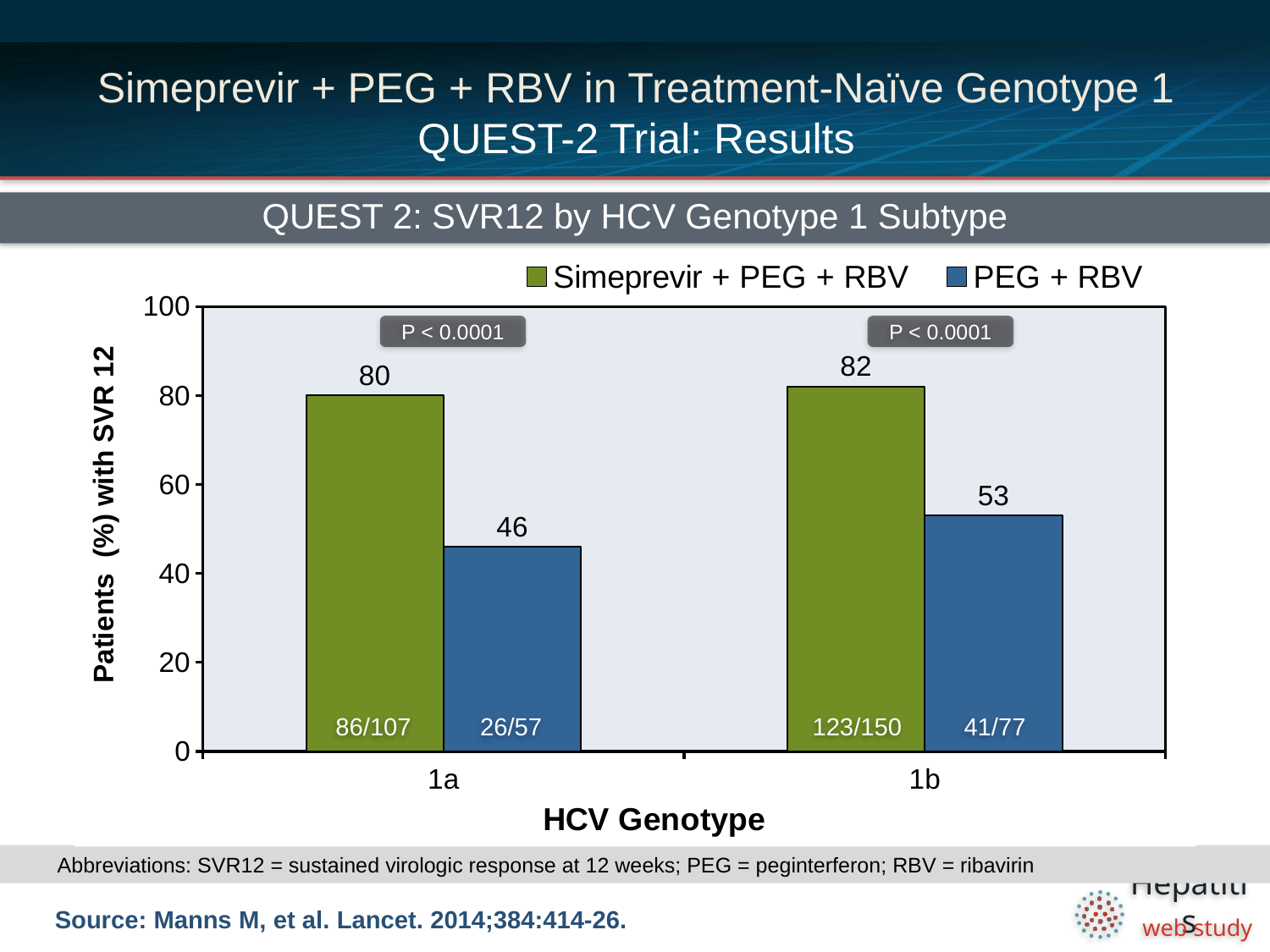
Which bar has the lowest SVR12 rate on the chart? PEG + RBV, genotype 1a Which bar has the highest SVR12 rate on the chart? Simeprevir + PEG + RBV, genotype 1b What kind of chart is shown on the slide? Bar chart What is the SVR12 rate for PEG + RBV in genotype 1a? 46 How many series does the legend list? 2 What is the difference in SVR12 rate between Simeprevir + PEG + RBV and PEG + RBV in genotype 1b? 29 Which has a higher SVR12 rate: PEG + RBV in genotype 1a or PEG + RBV in genotype 1b? PEG + RBV in genotype 1b What is the SVR12 rate for PEG + RBV in genotype 1b? 53 What fraction of patients is shown inside the Simeprevir + PEG + RBV bar for genotype 1b? 123/150 How many HCV genotype categories are shown on the x axis? 2 What is the SVR12 rate for Simeprevir + PEG + RBV in genotype 1a? 80 What is the difference in SVR12 rate between Simeprevir + PEG + RBV and PEG + RBV in genotype 1a? 34